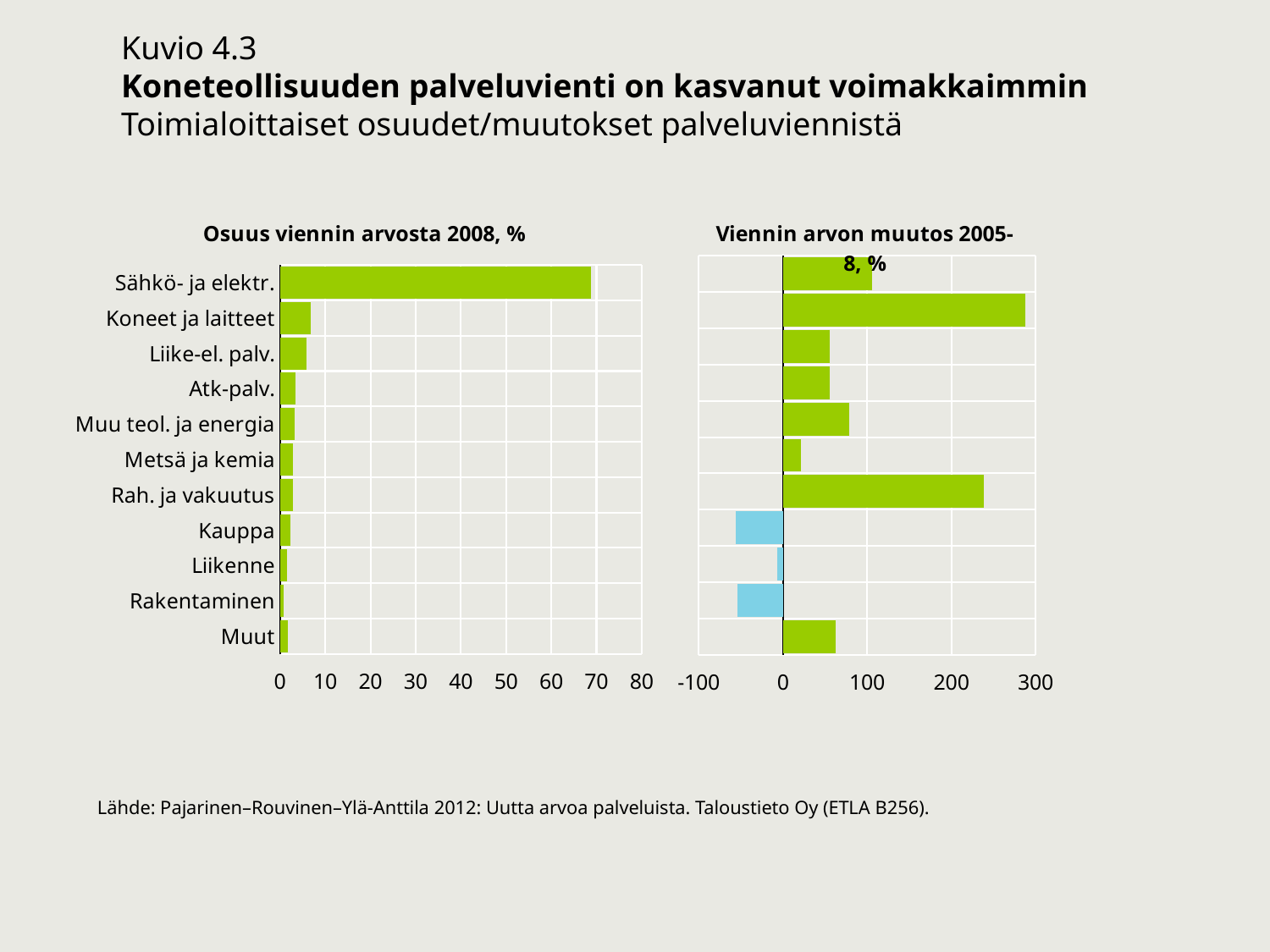
On the right chart "Viennin arvon muutos 2005-8, %", what colour are the bars with negative values? light blue On the left chart "Osuus viennin arvosta 2008, %", which category has the lowest value? Rakentaminen On the right chart "Viennin arvon muutos 2005-8, %", which category has the highest value? Koneet ja laitteet On the left chart "Osuus viennin arvosta 2008, %", is the value for Koneet ja laitteet greater or less than 10? less On the right chart "Viennin arvon muutos 2005-8, %", which is larger: Muu teol. ja energia or Metsä ja kemia? Muu teol. ja energia On the right chart "Viennin arvon muutos 2005-8, %", is the value for Rah. ja vakuutus greater or less than 200? greater On the left chart "Osuus viennin arvosta 2008, %", which category has the highest value? Sähkö- ja elektr. On the right chart "Viennin arvon muutos 2005-8, %", how many categories have a negative value? 3 On the left chart "Osuus viennin arvosta 2008, %", is the value for Sähkö- ja elektr. greater or less than 60? greater How many categories are shown on the left chart "Osuus viennin arvosta 2008, %"? 11 What kind of chart is the left chart titled "Osuus viennin arvosta 2008, %"? bar chart